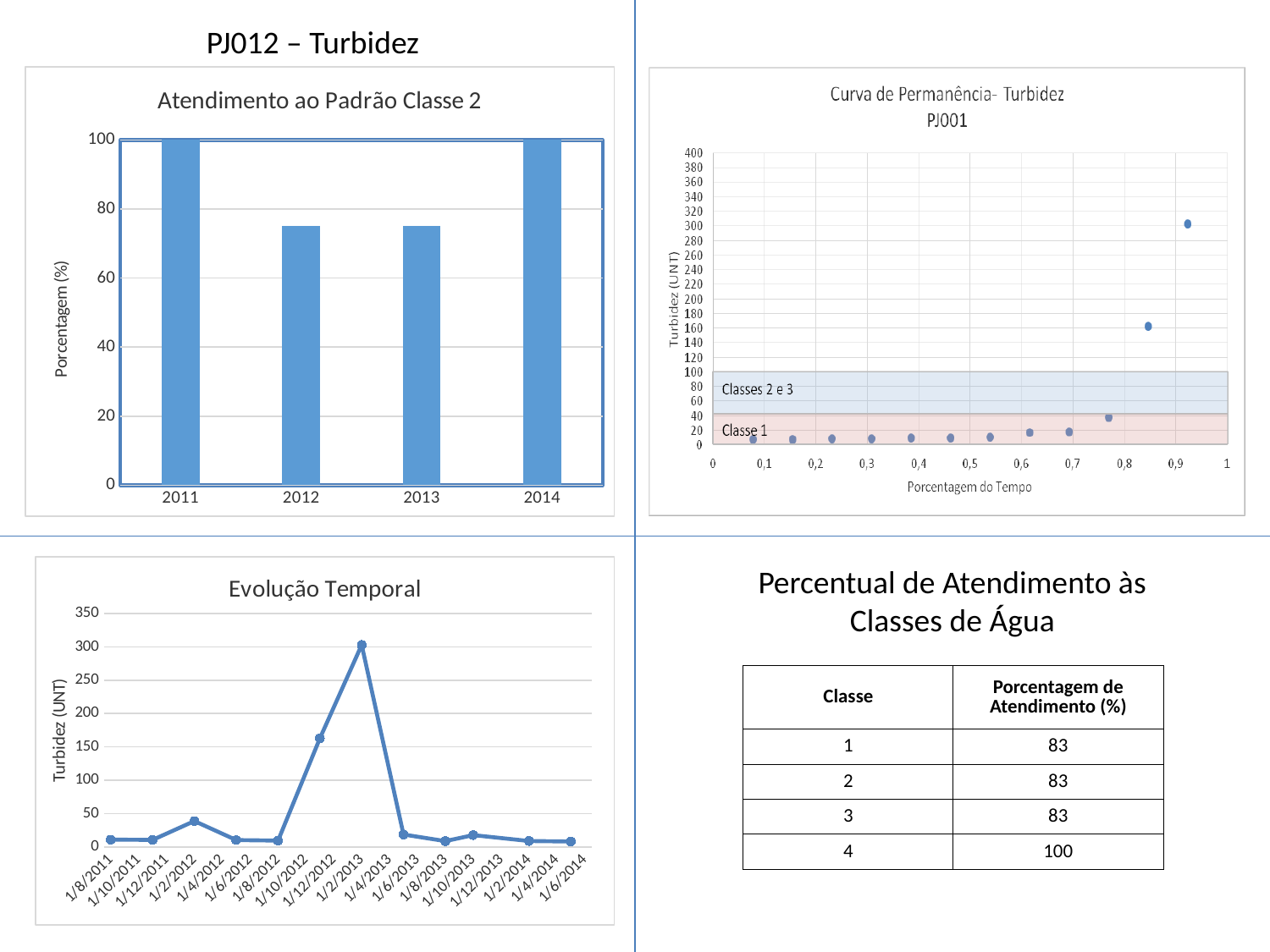
In the "Atendimento ao Padrão Classe 2" chart, which is larger, the value for 2011 or the value for 2012? 2011 In the "Curva de Permanência- Turbidez PJ001" chart, is the highest point greater or less than 280 UNT? greater What is the y-axis title of the "Atendimento ao Padrão Classe 2" chart? Porcentagem (%) In the "Evolução Temporal" chart, which date has the highest turbidity value? 1/2/2013 What is the y-axis title of the "Evolução Temporal" chart? Turbidez (UNT) What kind of chart is "Atendimento ao Padrão Classe 2"? bar chart In the "Atendimento ao Padrão Classe 2" chart, is the value for 2012 greater or less than 60? greater In the "Atendimento ao Padrão Classe 2" chart, how many years are shown on the x axis? 4 In the "Curva de Permanência- Turbidez PJ001" chart, do the values rise or fall as Porcentagem do Tempo increases? rise In the "Atendimento ao Padrão Classe 2" chart, what is the value for 2011? 100 In the "Atendimento ao Padrão Classe 2" chart, is the value for 2013 greater or less than 80? less